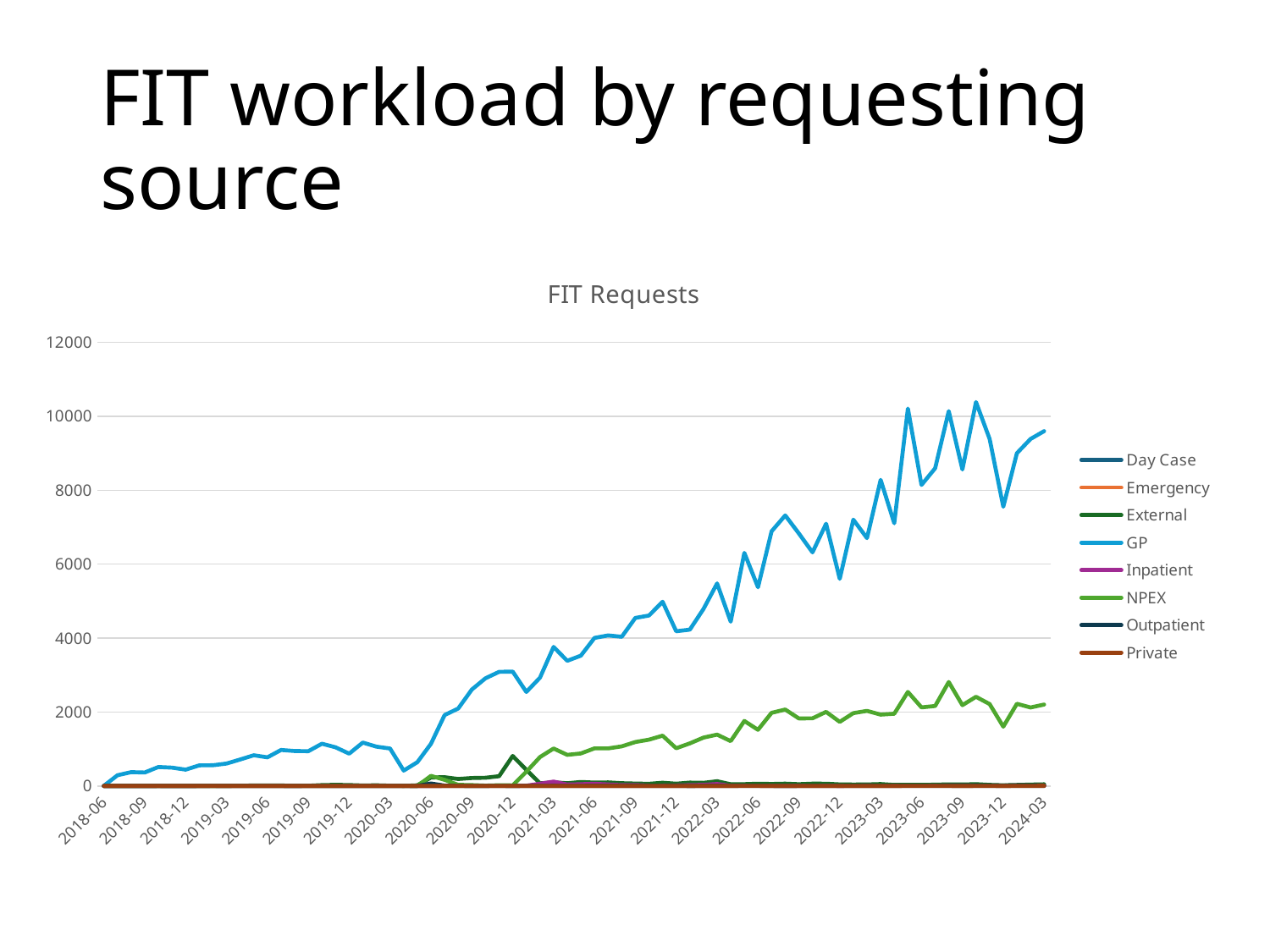
Is the value for NPEX at 2024-03 greater or less than 4000? less Which series has the highest values across the chart? GP What colour is the GP line in the legend? light blue What is the title of the chart? FIT Requests At 2024-03, which is larger: the GP value or the NPEX value? GP Does the GP series generally rise or fall from 2018-06 to 2024-03? rise Is the value for GP at 2018-06 greater or less than 2000? less Is the value for GP at 2024-03 greater or less than 8000? greater How many series does the legend list? 8 What kind of chart is shown on the slide? line chart